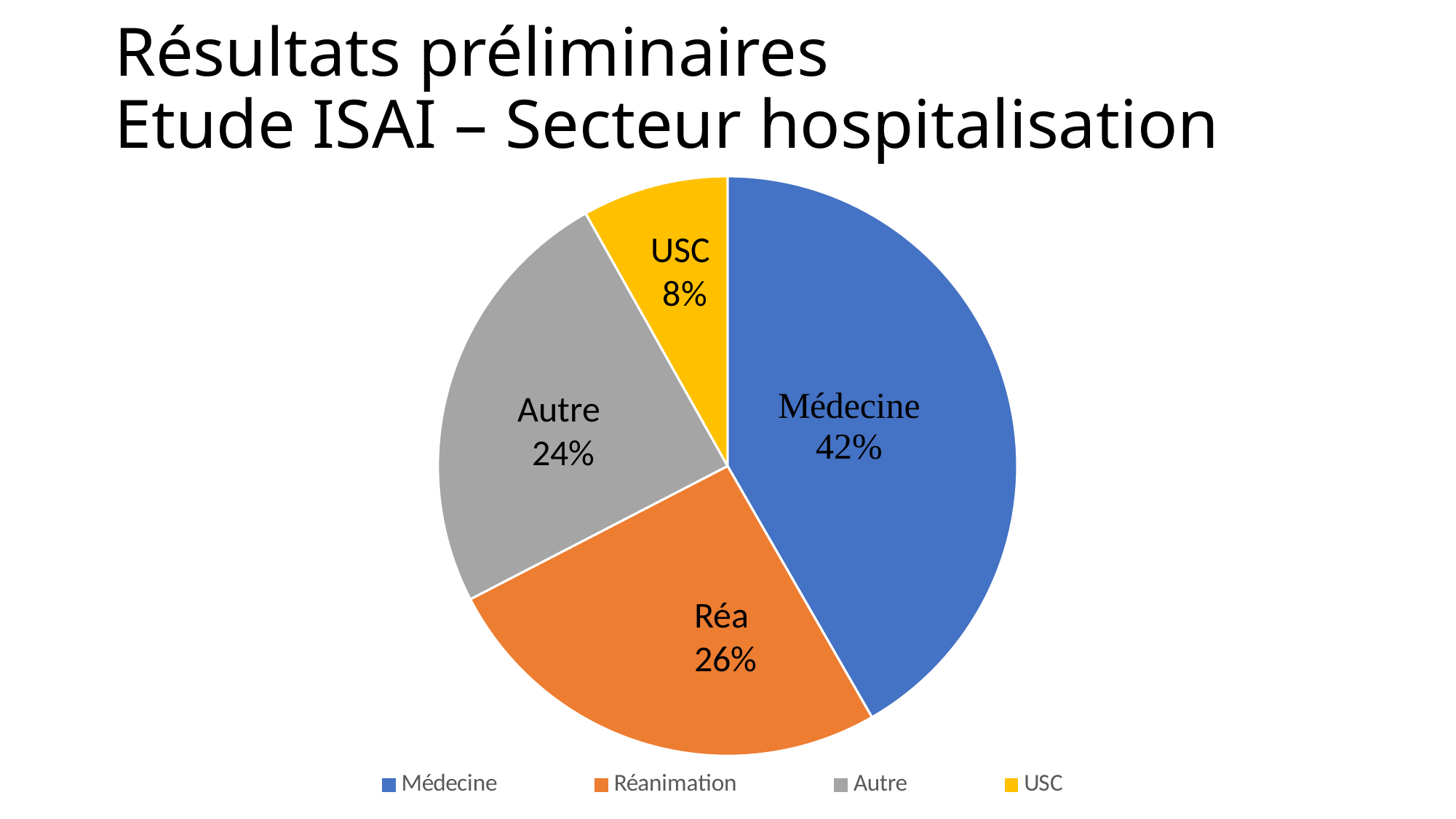
What percentage is shown for USC? 8% What colour is the Réanimation slice in the legend? Orange Which category has the largest share of the pie? Médecine What kind of chart is shown on the slide? Pie chart What percentage is shown for Réa? 26% Which is larger, the share for Réa or the share for Autre? Réa What percentage is shown for Autre? 24% What share of the pie does Médecine represent? 42% Which category has the smallest share of the pie? USC What is the difference in percentage points between Médecine and Réa? 16 How many slices does the pie chart have? 4 What is the difference in percentage points between Autre and USC? 16